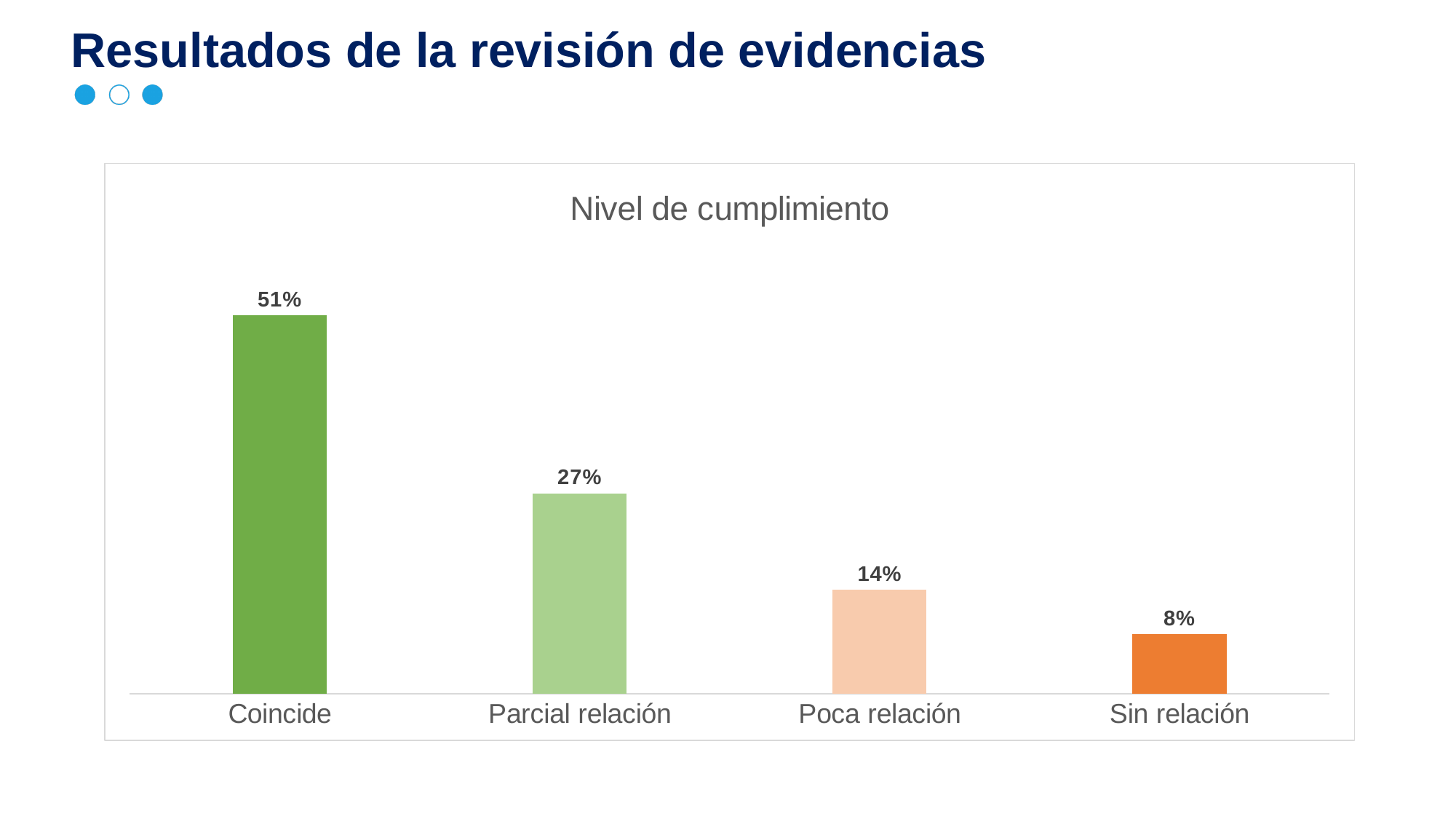
What is the difference between the values for Coincide and Parcial relación? 24% What is the value for Coincide? 51% What is the title of the chart? Nivel de cumplimiento What is the value for Poca relación? 14% What is the value for Sin relación? 8% How many categories are shown in the chart? 4 What kind of chart is shown on the slide? Bar chart Which category has the highest value? Coincide What is the value for Parcial relación? 27% What is the difference between the values for Poca relación and Sin relación? 6% Which category has the lowest value? Sin relación Which is larger, the value for Parcial relación or the value for Poca relación? Parcial relación